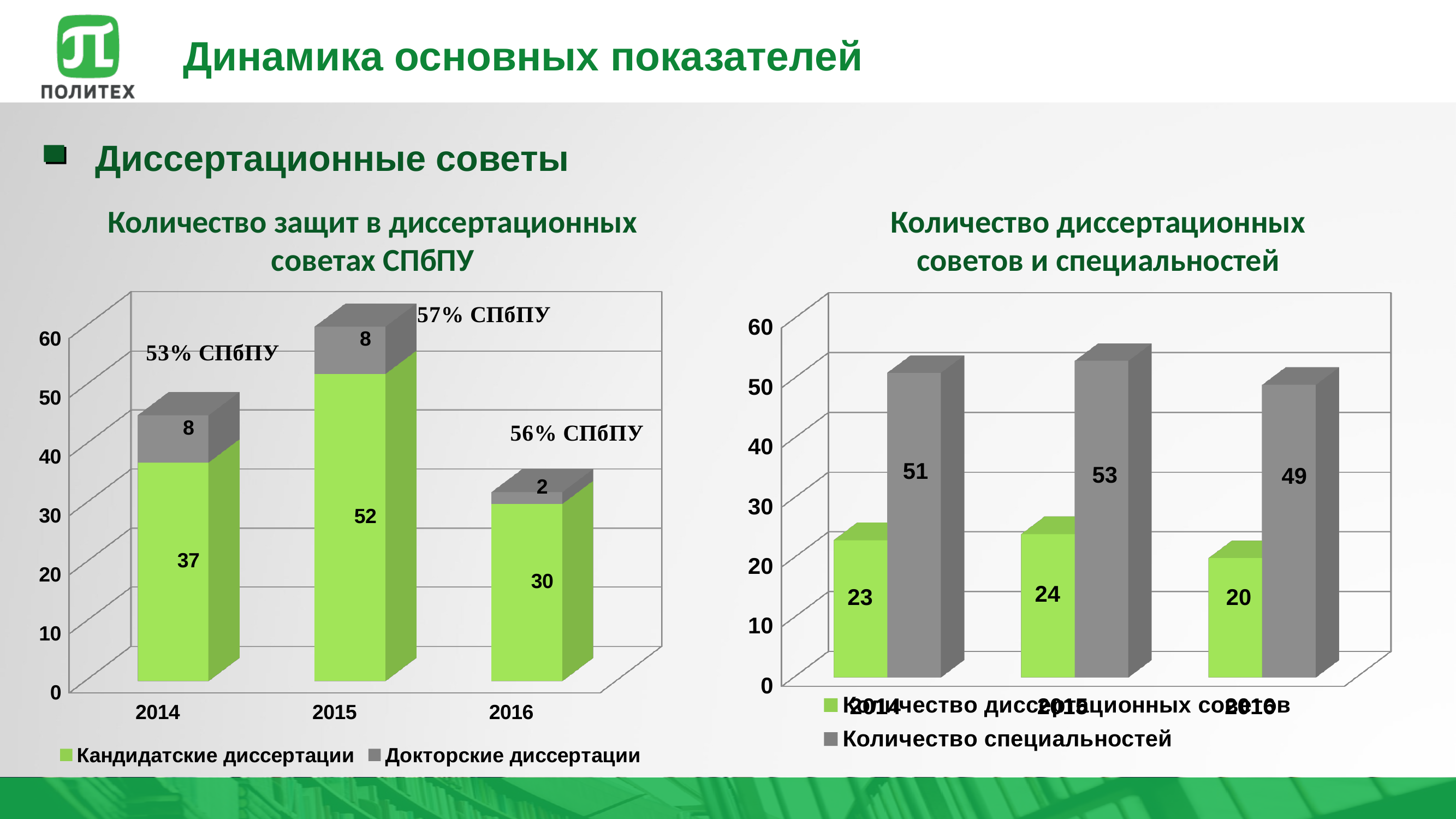
In the right chart (Количество диссертационных советов и специальностей), what is the difference between Количество специальностей and Количество диссертационных советов in 2014? 28 In the left chart (Количество защит в диссертационных советах СПбПУ), which year has the highest value for Кандидатские диссертации? 2015 In the right chart (Количество диссертационных советов и специальностей), which year has the lowest value for Количество диссертационных советов? 2016 In the left chart (Количество защит в диссертационных советах СПбПУ), what is the value for Докторские диссертации in 2016? 2 In the right chart (Количество диссертационных советов и специальностей), how many series does the legend list? 2 In the right chart (Количество диссертационных советов и специальностей), what is the value for Количество специальностей in 2015? 53 In the right chart (Количество диссертационных советов и специальностей), is the value for Количество специальностей in 2016 greater or less than 40? greater In the left chart (Количество защит в диссертационных советах СПбПУ), what is the value for Кандидатские диссертации in 2015? 52 In the left chart (Количество защит в диссертационных советах СПбПУ), what is the difference between Кандидатские диссертации in 2015 and 2016? 22 In the left chart (Количество защит в диссертационных советах СПбПУ), what is the total of the stacked bar for 2014? 45 In the left chart (Количество защит в диссертационных советах СПбПУ), what kind of chart is shown? Stacked bar chart In the left chart (Количество защит в диссертационных советах СПбПУ), what percentage label is shown above the 2015 bar? 57% СПбПУ